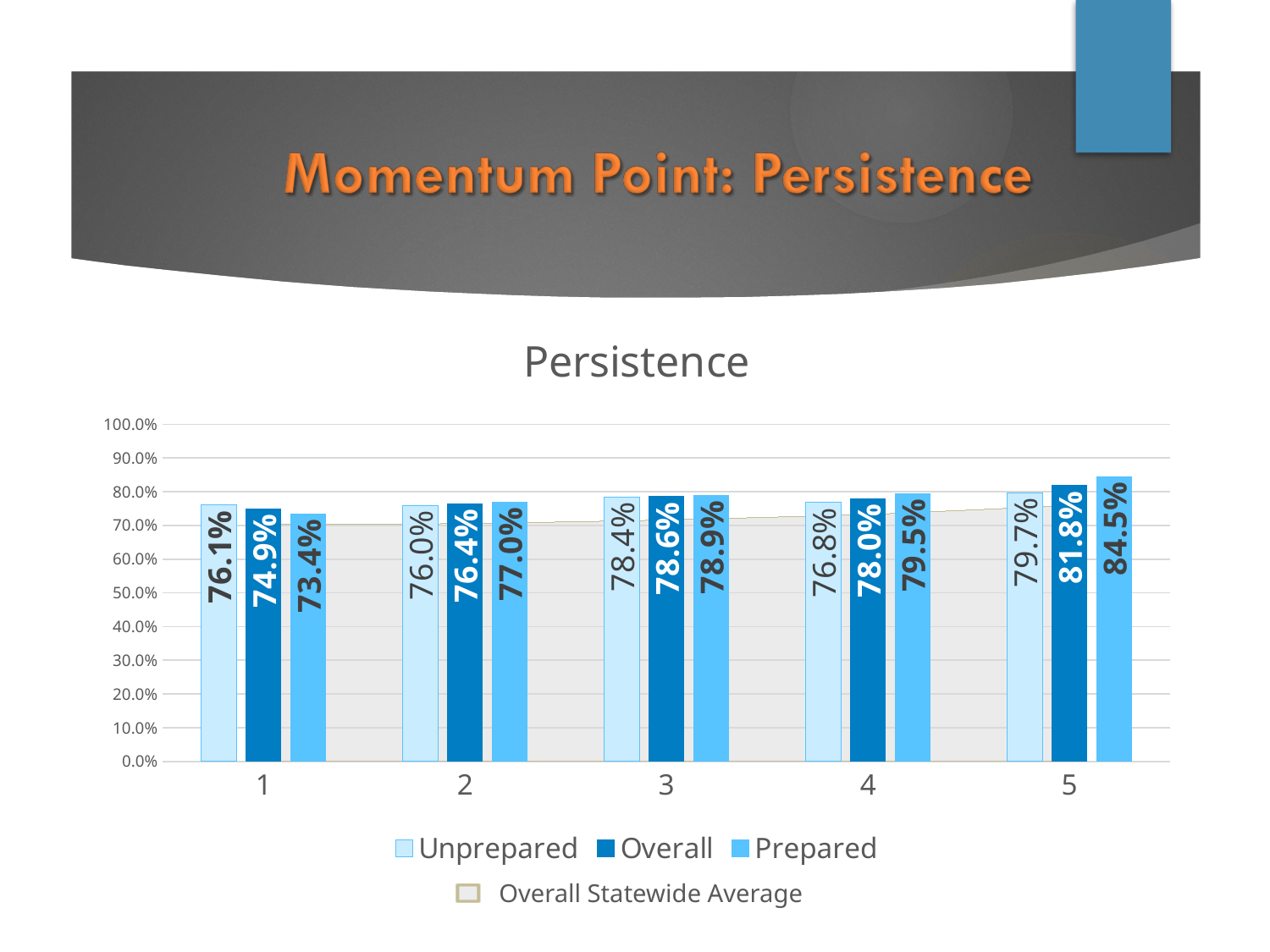
What kind of chart is shown on the slide? combination bar and area chart Which category has the highest Prepared value? 5 Do the Prepared values rise or fall from category 1 to category 5? rise What is the Unprepared value for category 3? 78.4% What is the Prepared value for category 5? 84.5% What is the title of the chart? Persistence What is the Overall value for category 2? 76.4% Which category has the lowest Overall value? 1 Is the Overall Statewide Average at category 1 greater or less than 80.0%? less What is the difference between the Prepared and Unprepared values for category 5? 4.8 percentage points For category 1, which is larger: the Unprepared value or the Prepared value? Unprepared How many categories are shown on the x axis? 5